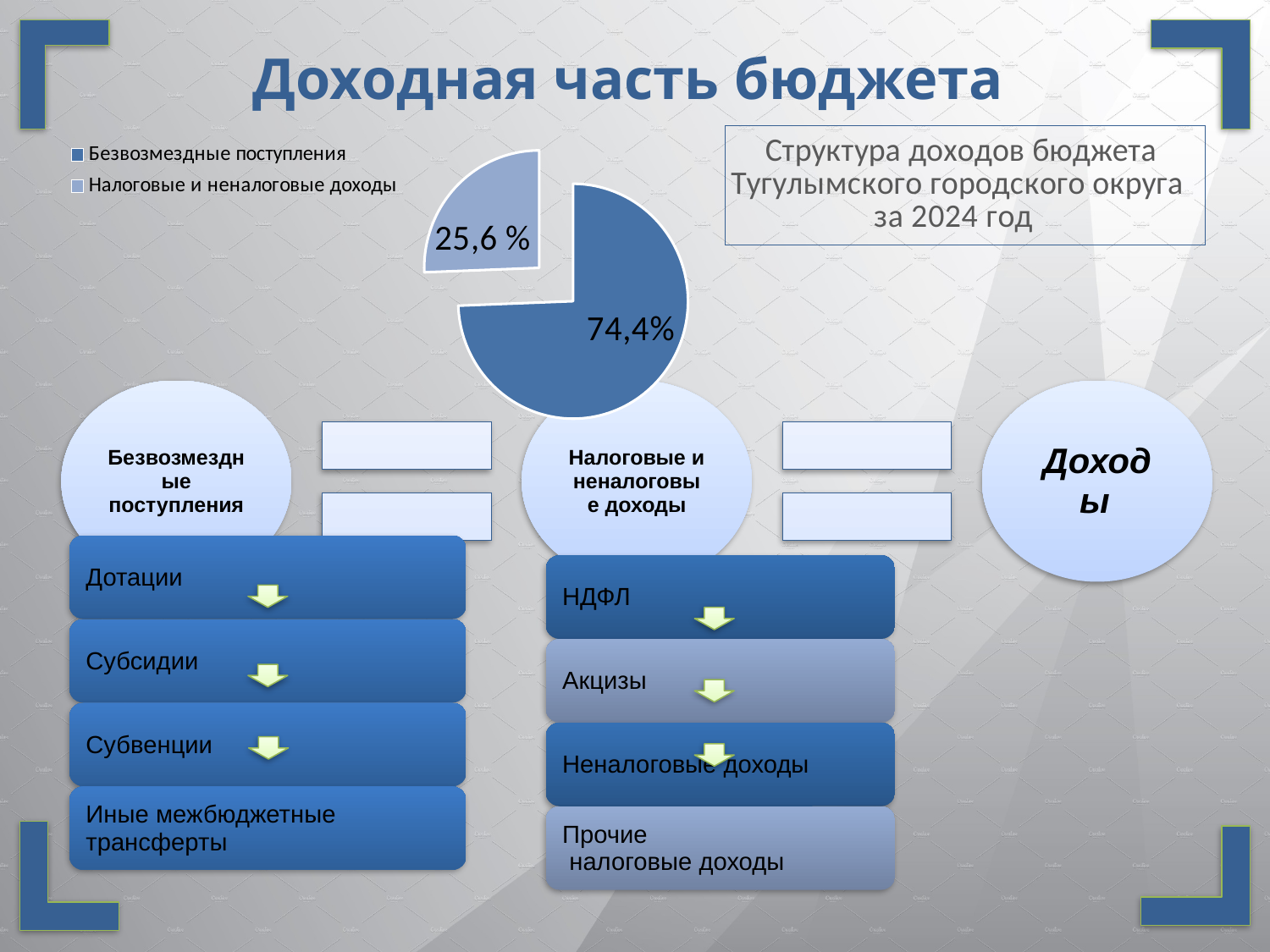
How many slices does the pie chart have? 2 How many entries does the chart legend list? 2 By how many percentage points does the Безвозмездные поступления slice exceed the Налоговые и неналоговые доходы slice? 48,8 What share of the pie chart does the slice for Безвозмездные поступления represent? 74,4% Which category has the smallest slice in the pie chart? Налоговые и неналоговые доходы What type of chart is shown on the slide? Pie chart Which category has the largest slice in the pie chart? Безвозмездные поступления What is the title shown in the box next to the pie chart? Структура доходов бюджета Тугулымского городского округа за 2024 год Which slice is larger: Безвозмездные поступления or Налоговые и неналоговые доходы? Безвозмездные поступления What share of the pie chart does the slice for Налоговые и неналоговые доходы represent? 25,6 % Which legend entry is shown in the darker blue colour? Безвозмездные поступления